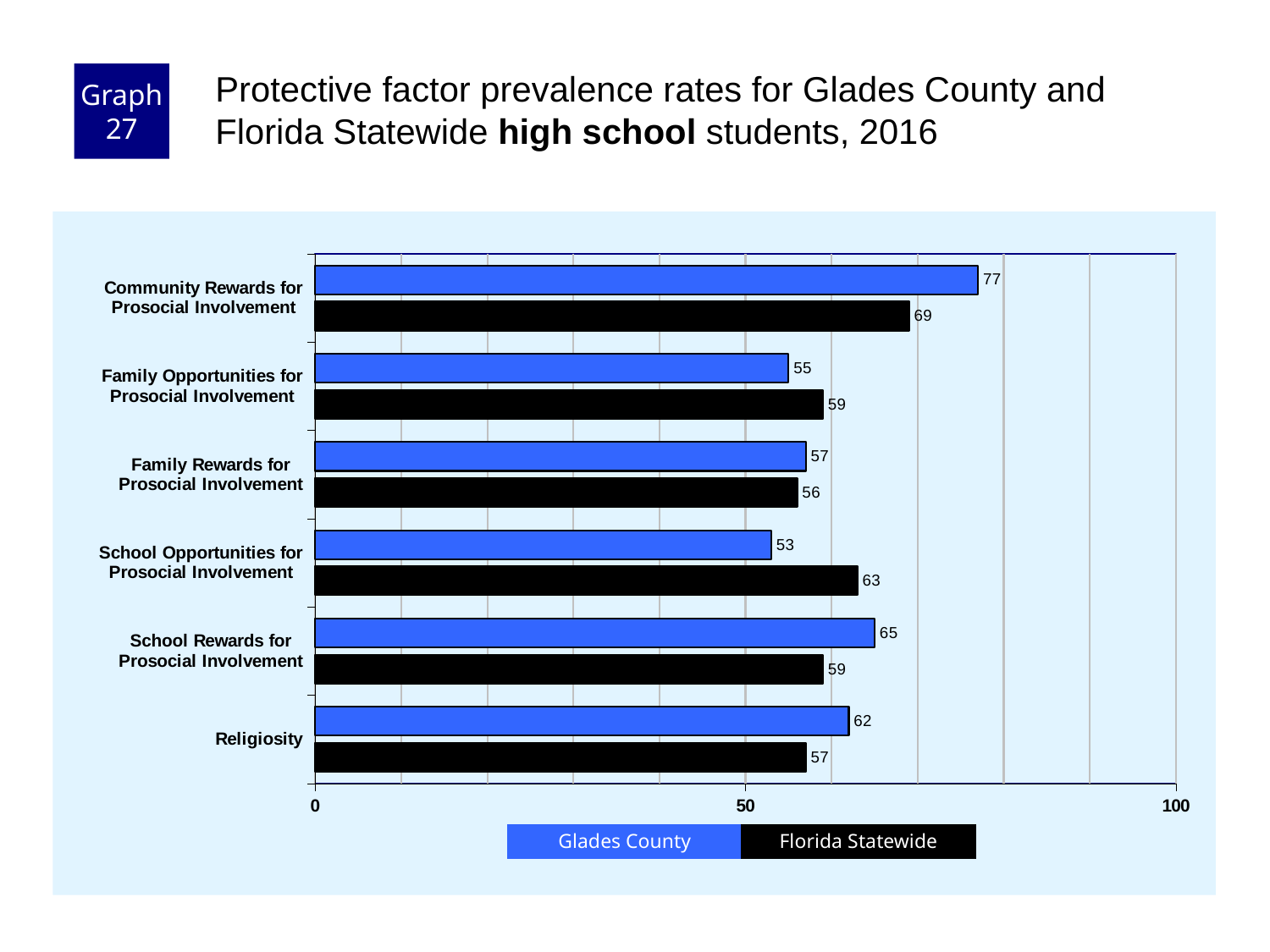
What is the difference between the Glades County and Florida Statewide values for Community Rewards for Prosocial Involvement? 8 What is the difference between the Glades County and Florida Statewide values for School Opportunities for Prosocial Involvement? 10 How many protective factors are shown on the chart? 6 What is the Glades County value for Religiosity? 62 What is the Glades County value for Community Rewards for Prosocial Involvement? 77 Is the Florida Statewide value for Family Rewards for Prosocial Involvement greater or less than 50? greater Which protective factor has the highest Glades County value? Community Rewards for Prosocial Involvement How many series does the legend list? 2 For School Rewards for Prosocial Involvement, which is larger: the Glades County value or the Florida Statewide value? Glades County What is the Florida Statewide value for School Opportunities for Prosocial Involvement? 63 What kind of chart is shown on the slide? Bar chart Which protective factor has the lowest Glades County value? School Opportunities for Prosocial Involvement